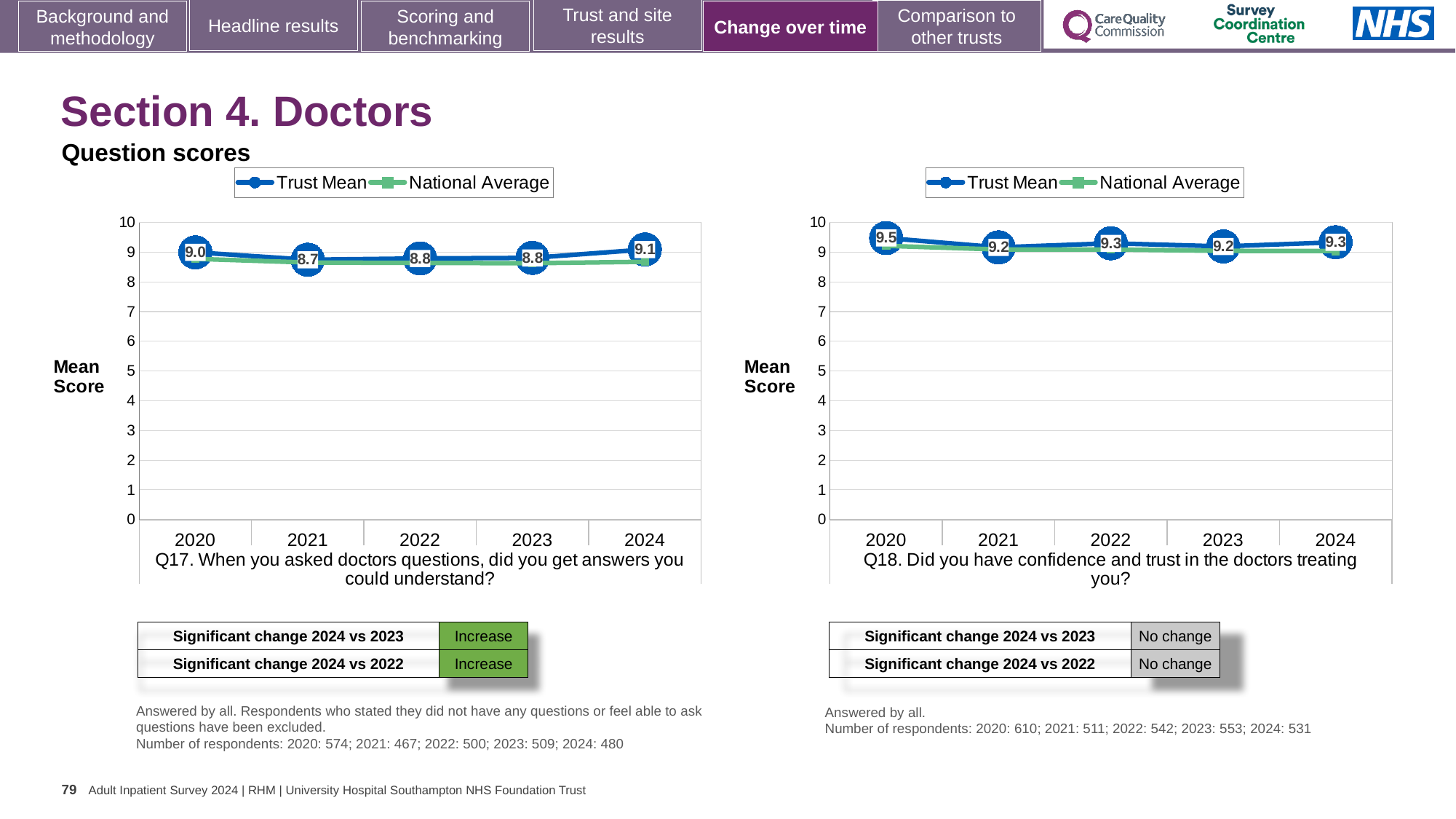
On the Q17 chart (left), what is the Trust Mean score for 2021? 8.7 On the Q18 chart (right), what is the Trust Mean score for 2023? 9.2 On the Q17 chart (left), is the Trust Mean score for 2020 greater or less than 8? greater On the Q17 chart (left), what is the difference between the Trust Mean scores for 2024 and 2021? 0.4 On the Q17 chart (left), which year has the lowest Trust Mean score? 2021 On the Q18 chart (right), what is the Trust Mean score for 2020? 9.5 On the Q18 chart (right), is the Trust Mean score for 2020 larger than the score for 2021? Yes, 2020 (9.5) is larger than 2021 (9.2) On the Q18 chart (right), which year has the highest Trust Mean score? 2020 How many years are plotted on the Q17 chart (left)? 5 How many series does the legend of the Q18 chart (right) list? 2 What type of chart is used for Q17 (left)? Line chart On the Q17 chart (left), what is the Trust Mean score for 2024? 9.1